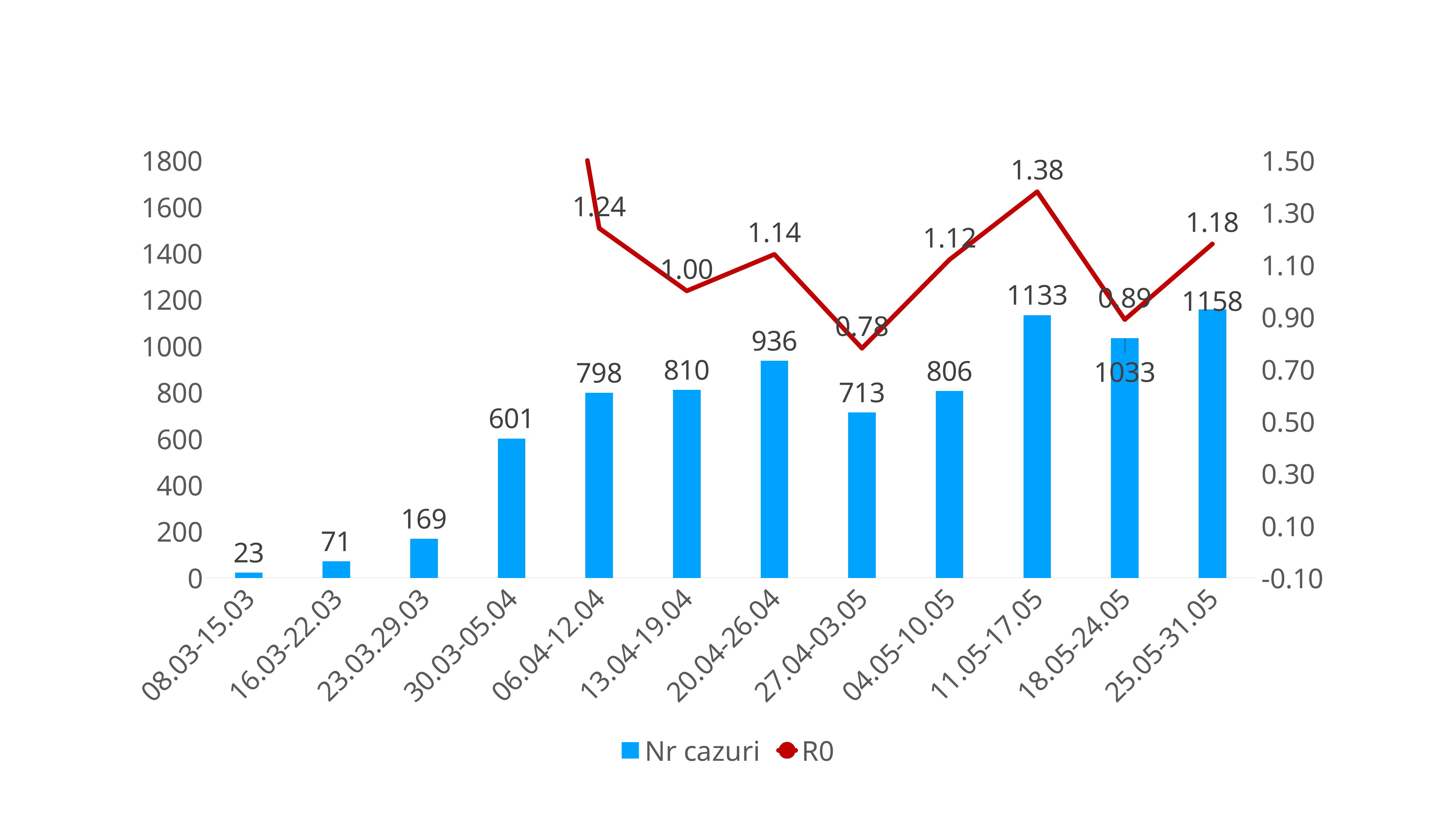
What is the value of Nr cazuri for 08.03-15.03? 23 Which period has the lowest labelled R0 value? 27.04-03.05 Which period has the highest Nr cazuri? 25.05-31.05 How many series does the legend list? 2 How many periods are shown on the x axis? 12 Which period has the lowest Nr cazuri? 08.03-15.03 What kind of chart is this? Combination bar and line chart What is the difference in Nr cazuri between 25.05-31.05 and 18.05-24.05? 125 Which is larger, Nr cazuri for 13.04-19.04 or for 04.05-10.05? 13.04-19.04 What is the R0 value for 27.04-03.05? 0.78 What is the value of Nr cazuri for 20.04-26.04? 936 What is the R0 value for 11.05-17.05? 1.38